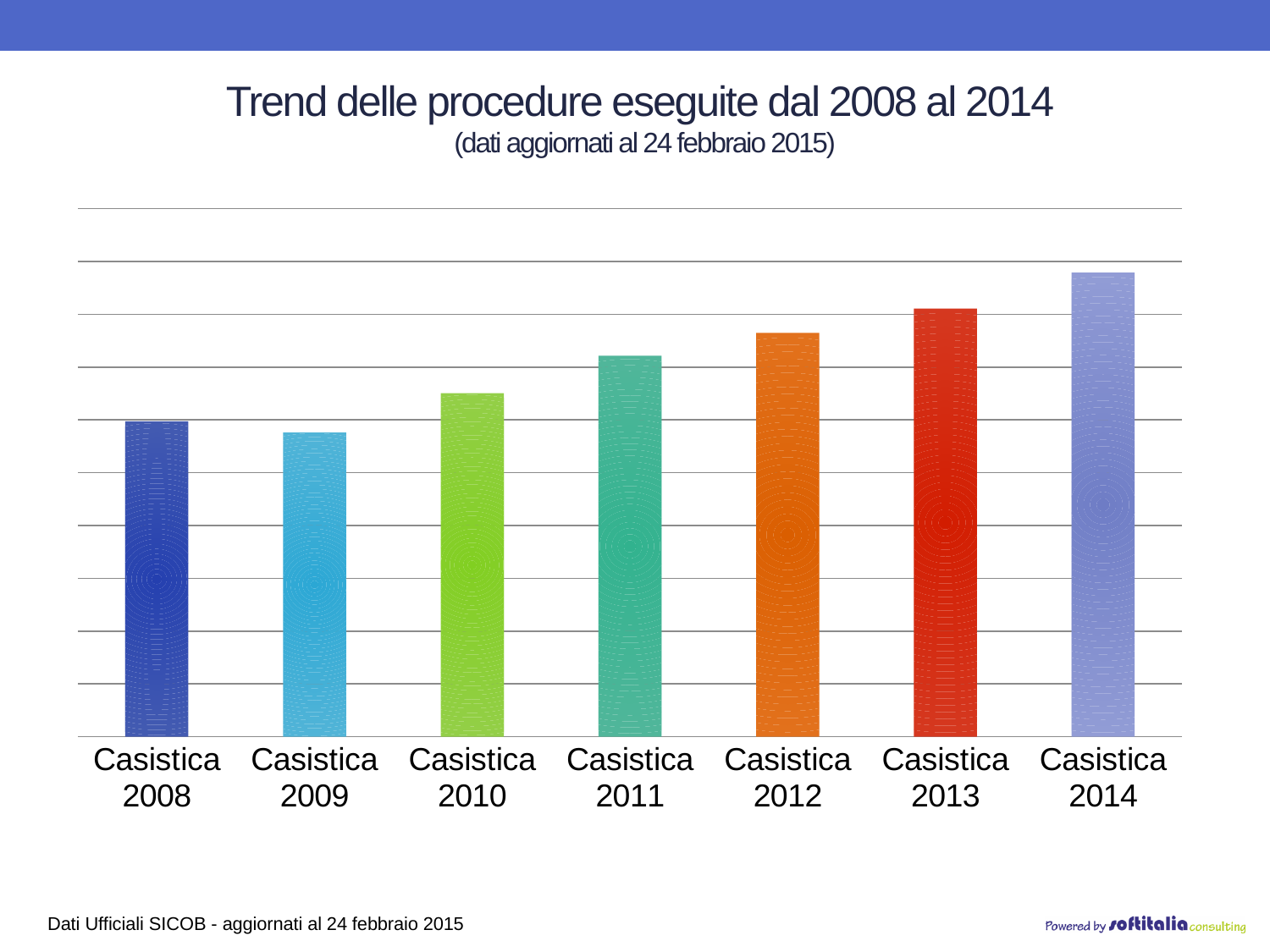
Which category has the highest bar? Casistica 2014 What is the title of the chart on the slide? Trend delle procedure eseguite dal 2008 al 2014 Which is larger, the bar for Casistica 2013 or the bar for Casistica 2011? Casistica 2013 Do the bars generally rise or fall from Casistica 2009 to Casistica 2014? rise What is the label of the first category on the x axis? Casistica 2008 What kind of chart is shown on the slide? bar chart Which is larger, the bar for Casistica 2012 or the bar for Casistica 2010? Casistica 2012 How many categories (bars) does the chart show? 7 Which is larger, the bar for Casistica 2008 or the bar for Casistica 2009? Casistica 2008 Which category has the lowest bar? Casistica 2009